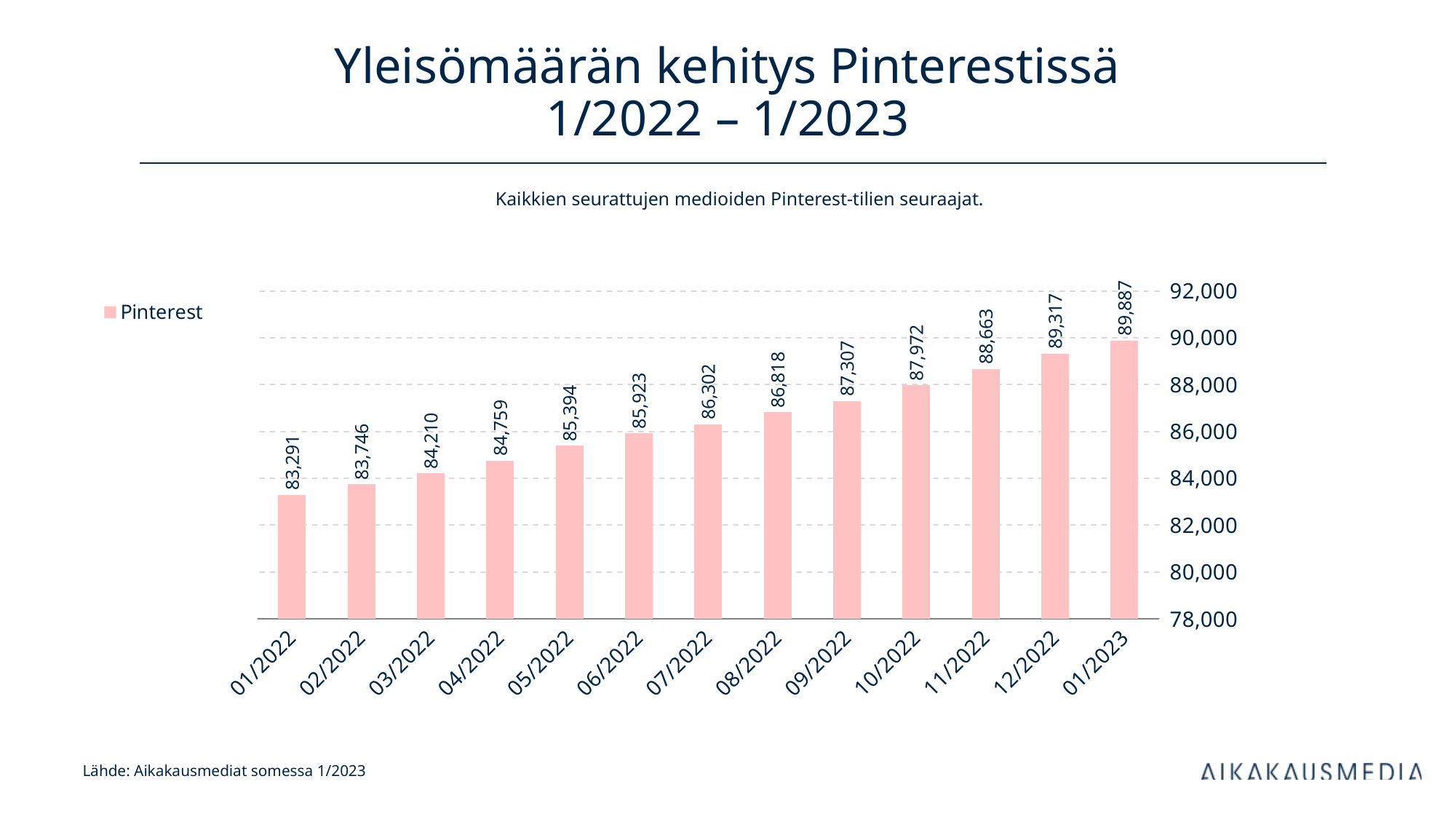
What is the value for 01/2022? 83,291 What is the value for 07/2022? 86,302 What is the difference between the values for 01/2023 and 01/2022? 6,596 Do the values rise or fall from 01/2022 to 01/2023? rise Which is larger, the value for 05/2022 or the value for 09/2022? 09/2022 Which month has the lowest value? 01/2022 How many months are shown on the x axis? 13 How many series does the legend list? 1 What kind of chart is shown? bar chart What is the value for 01/2023? 89,887 Which month has the highest value? 01/2023 What is the difference between the values for 12/2022 and 11/2022? 654